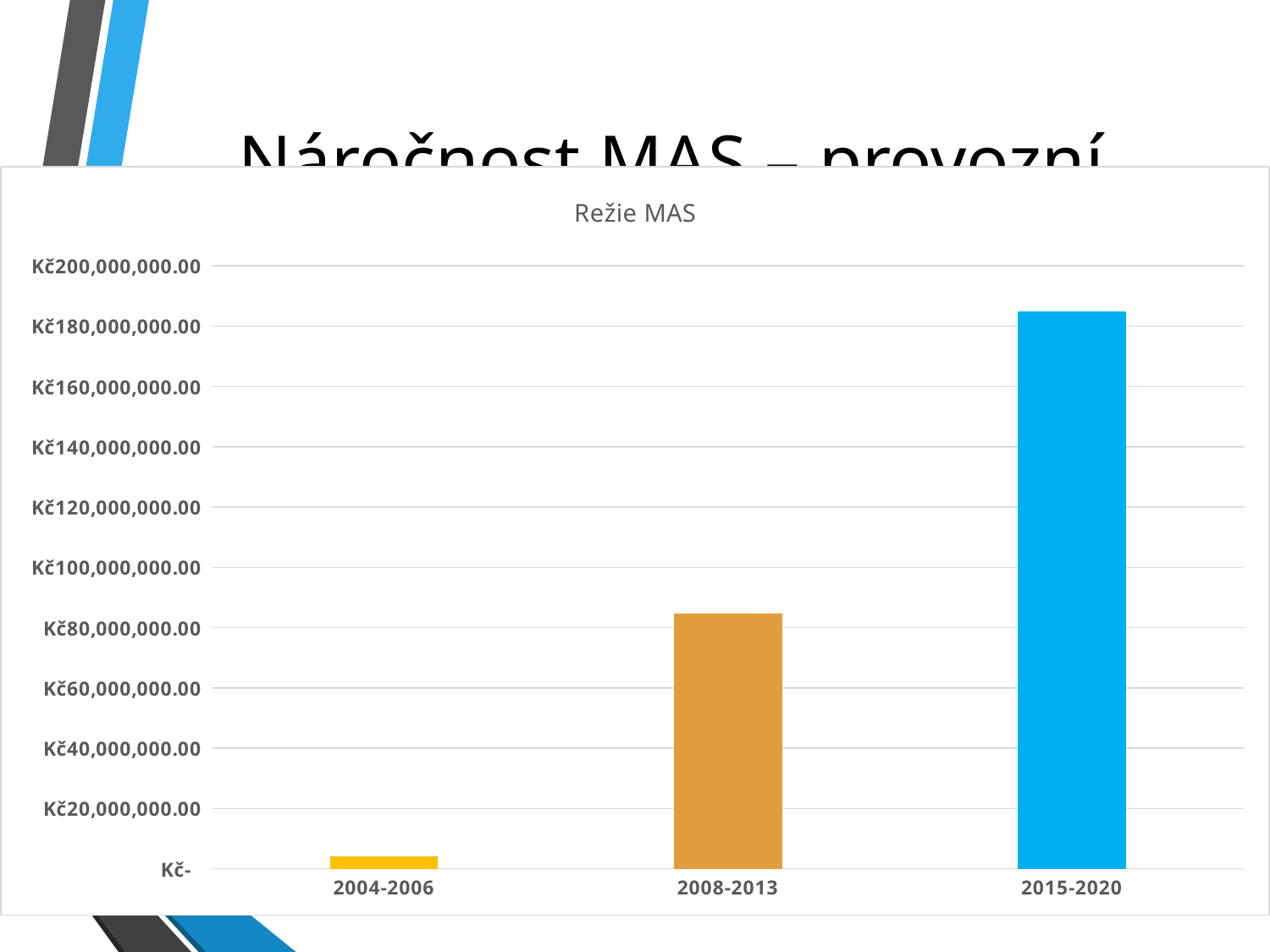
How many categories are shown on the x axis of the chart? 3 Which period has the lowest value in the chart? 2004-2006 Is the value for 2008-2013 greater or less than Kč100,000,000.00? less Which is larger, the value for 2004-2006 or the value for 2008-2013? 2008-2013 Do the values rise or fall from 2004-2006 to 2015-2020? rise Which is larger, the value for 2008-2013 or the value for 2015-2020? 2015-2020 Is the value for 2004-2006 greater or less than Kč20,000,000.00? less What kind of chart is shown on the slide? bar chart Is the value for 2015-2020 greater or less than Kč160,000,000.00? greater Which period has the highest value in the chart? 2015-2020 What is the title of the chart? Režie MAS